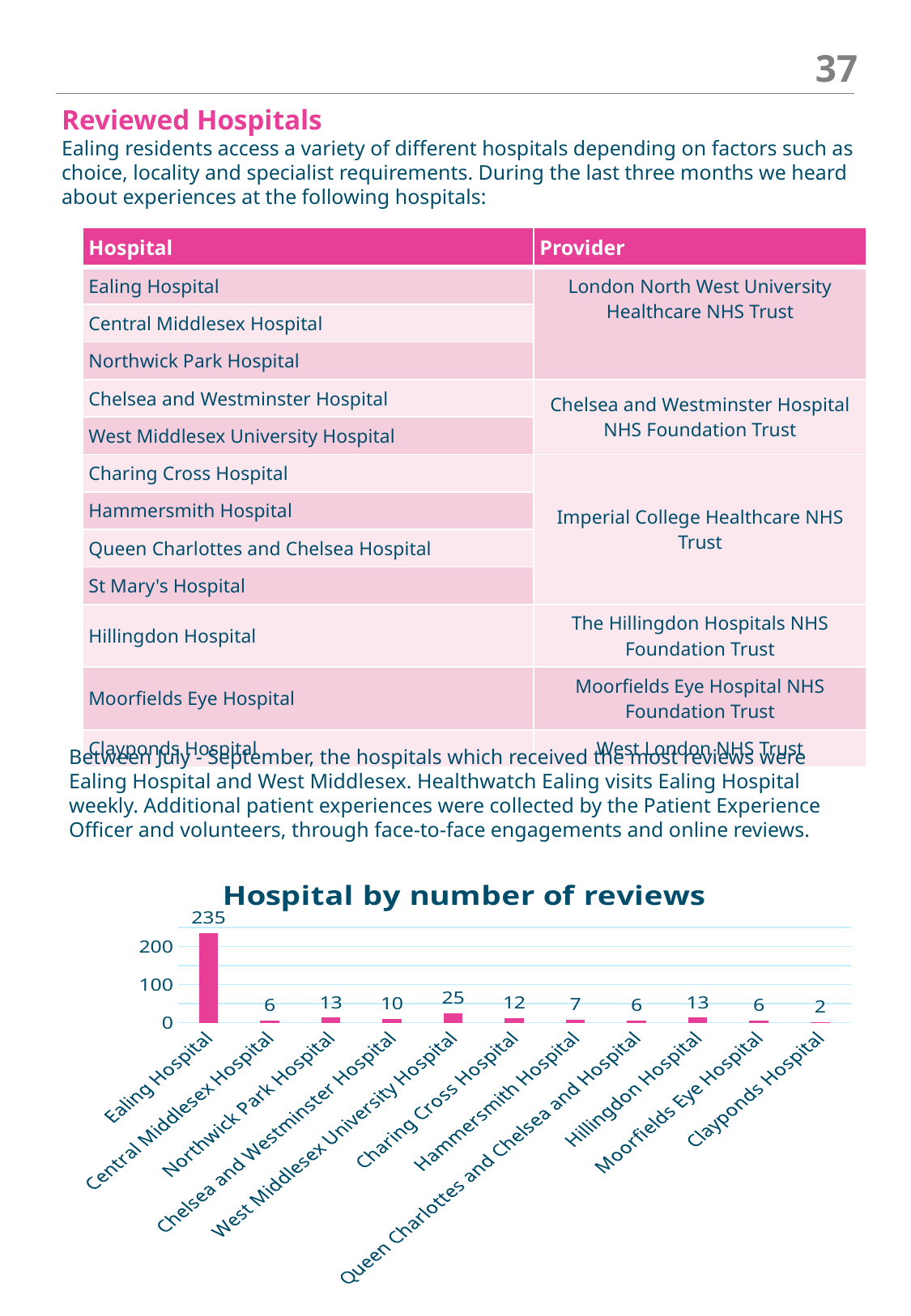
What type of chart is used to show the number of reviews by hospital? Bar chart What is the title of the chart? Hospital by number of reviews What is the difference in number of reviews between Ealing Hospital and West Middlesex University Hospital? 210 How many hospitals are shown in the chart? 11 Which hospital has the lowest number of reviews? Clayponds Hospital Which hospital has the highest number of reviews? Ealing Hospital What is the number of reviews for West Middlesex University Hospital? 25 What is the number of reviews for Charing Cross Hospital? 12 Which has more reviews, Charing Cross Hospital or Hammersmith Hospital? Charing Cross Hospital What is the number of reviews for Hammersmith Hospital? 7 What is the number of reviews for Ealing Hospital? 235 What is the difference in number of reviews between Northwick Park Hospital and Chelsea and Westminster Hospital? 3